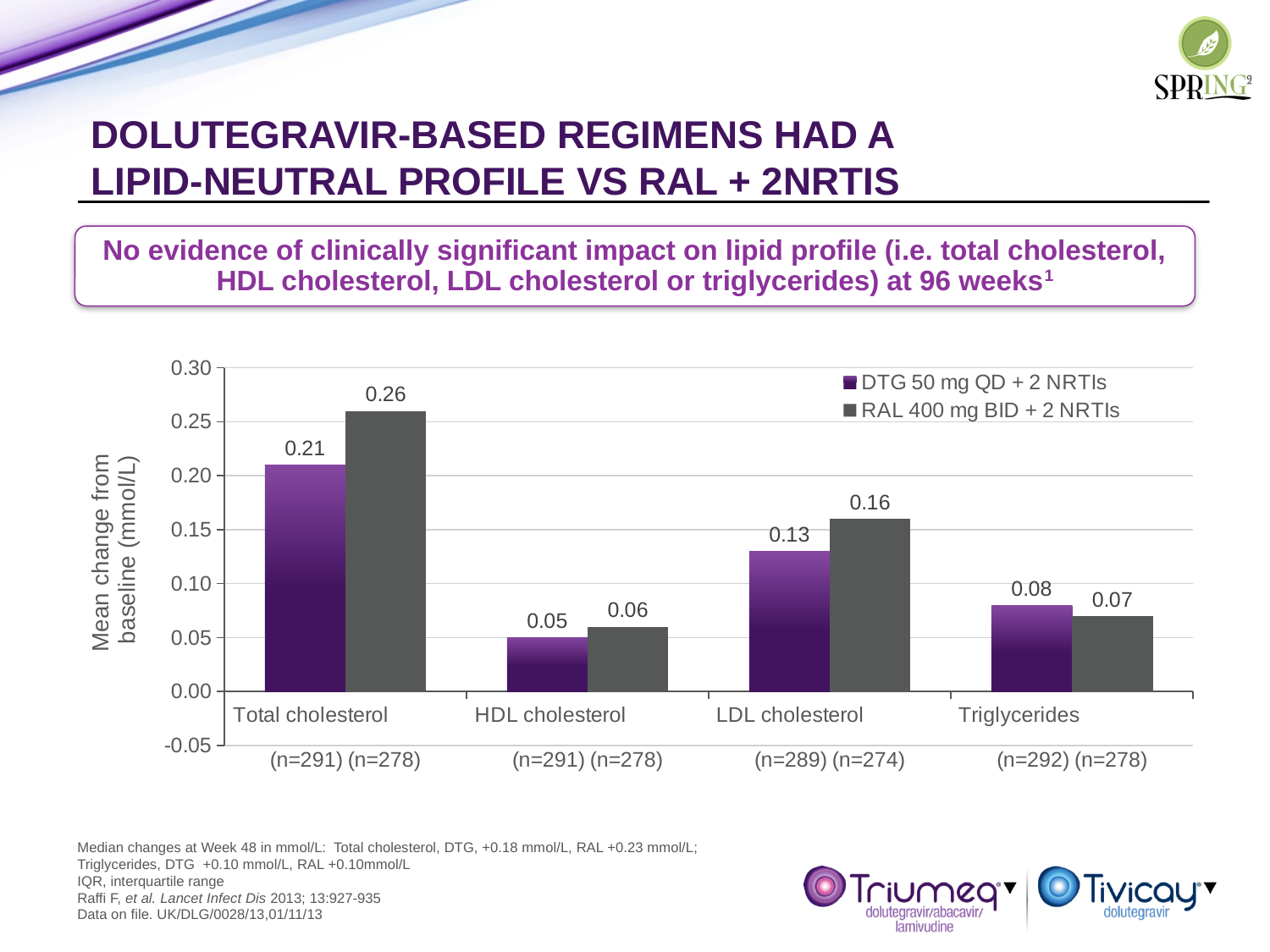
For LDL cholesterol, which regimen has the larger mean change from baseline? RAL 400 mg BID + 2 NRTIs Which lipid category has the lowest mean change from baseline for DTG 50 mg QD + 2 NRTIs? HDL cholesterol What kind of chart is shown on the slide? Bar chart What is the mean change from baseline in triglycerides for DTG 50 mg QD + 2 NRTIs? 0.08 What is the y-axis label of the chart? Mean change from baseline (mmol/L) What is the mean change from baseline in total cholesterol for DTG 50 mg QD + 2 NRTIs? 0.21 What is the mean change from baseline in LDL cholesterol for RAL 400 mg BID + 2 NRTIs? 0.16 Which lipid category has the highest mean change from baseline for RAL 400 mg BID + 2 NRTIs? Total cholesterol What is the difference between the RAL and DTG mean changes from baseline for total cholesterol? 0.05 What is the sample size (n) shown for the DTG group in the LDL cholesterol category? n=289 How many lipid categories are shown on the x axis? 4 How many series does the legend list? 2